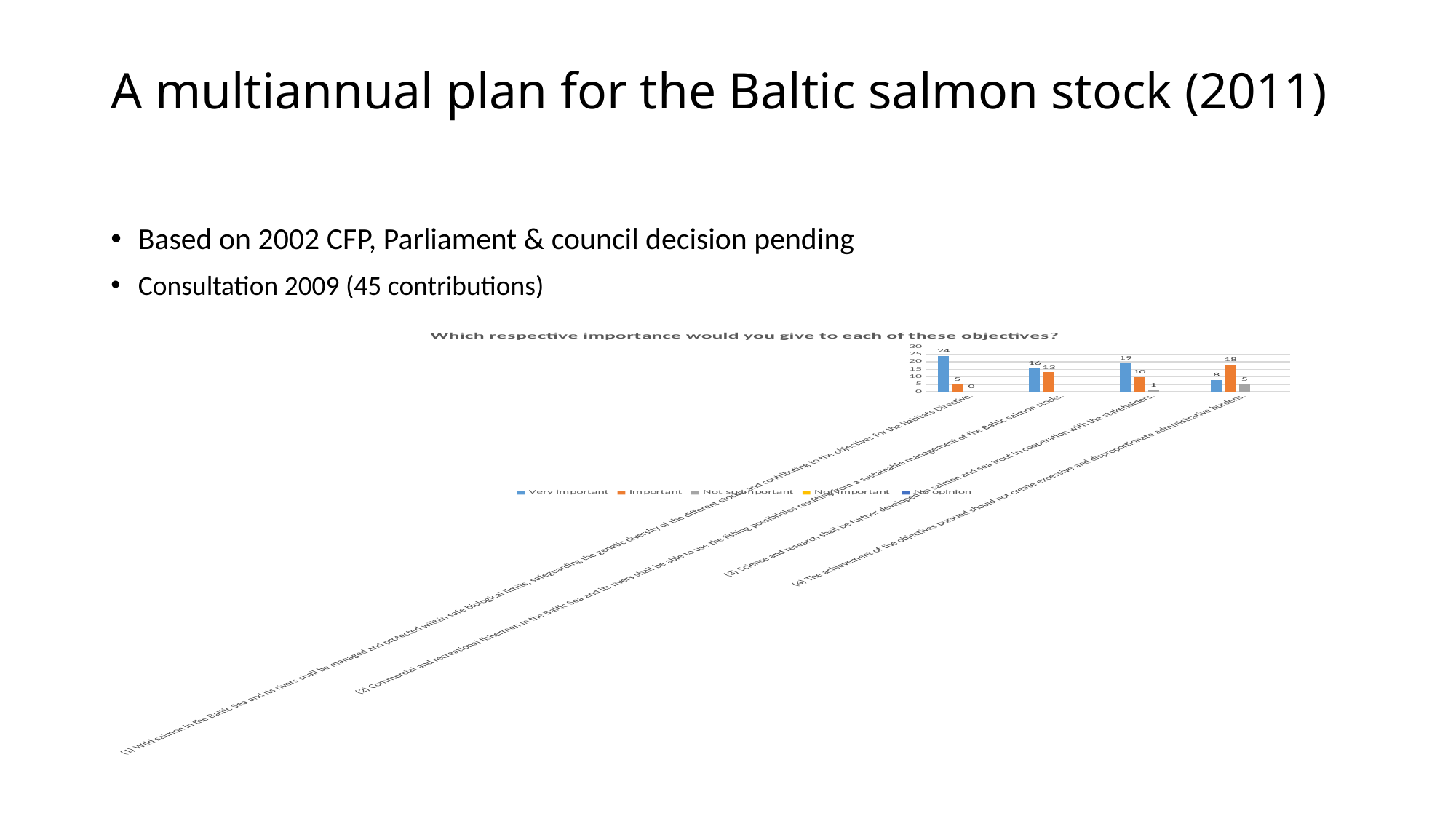
For objective (4), which is larger: the 'Very important' value or the 'Important' value? Important Which objective has the highest 'Very important' value? Objective (1) How many objectives (categories) are plotted on the x axis? 4 What is the difference between the 'Very important' and 'Important' values for objective (1)? 19 What is the 'Not so important' value for objective (3)? 1 What is the 'Important' value for objective (4)? 18 What is the title of the chart? Which respective importance would you give to each of these objectives? Which objective has the lowest 'Very important' value? Objective (4) What kind of chart is shown on the slide? bar chart What is the 'Important' value for objective (2)? 13 How many series does the chart legend list? 5 What is the 'Very important' value for objective (1)? 24